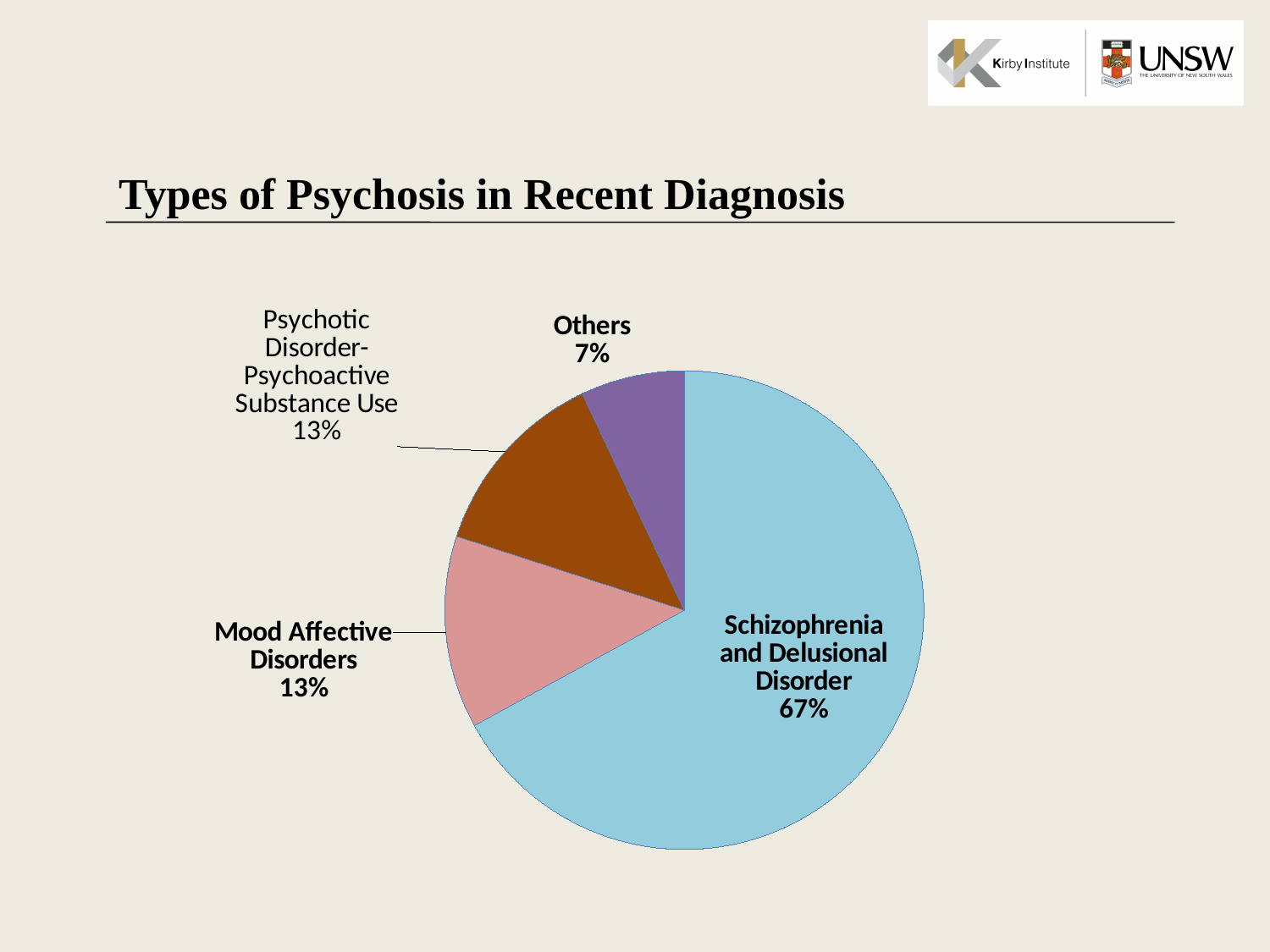
What percentage is shown for Others? 7% What colour is the slice for Schizophrenia and Delusional Disorder? Light blue What is the difference in percentage points between Schizophrenia and Delusional Disorder and Others? 60 Which is larger, the share for Mood Affective Disorders or the share for Others? Mood Affective Disorders What type of chart is shown on the slide? Pie chart What percentage is shown for Mood Affective Disorders? 13% Which category has the smallest slice of the pie? Others What percentage is shown for Psychotic Disorder-Psychoactive Substance Use? 13% What share of the pie is Schizophrenia and Delusional Disorder? 67% What is the title of the chart? Types of Psychosis in Recent Diagnosis How many categories are shown in the pie chart? 4 Which category has the largest slice of the pie? Schizophrenia and Delusional Disorder